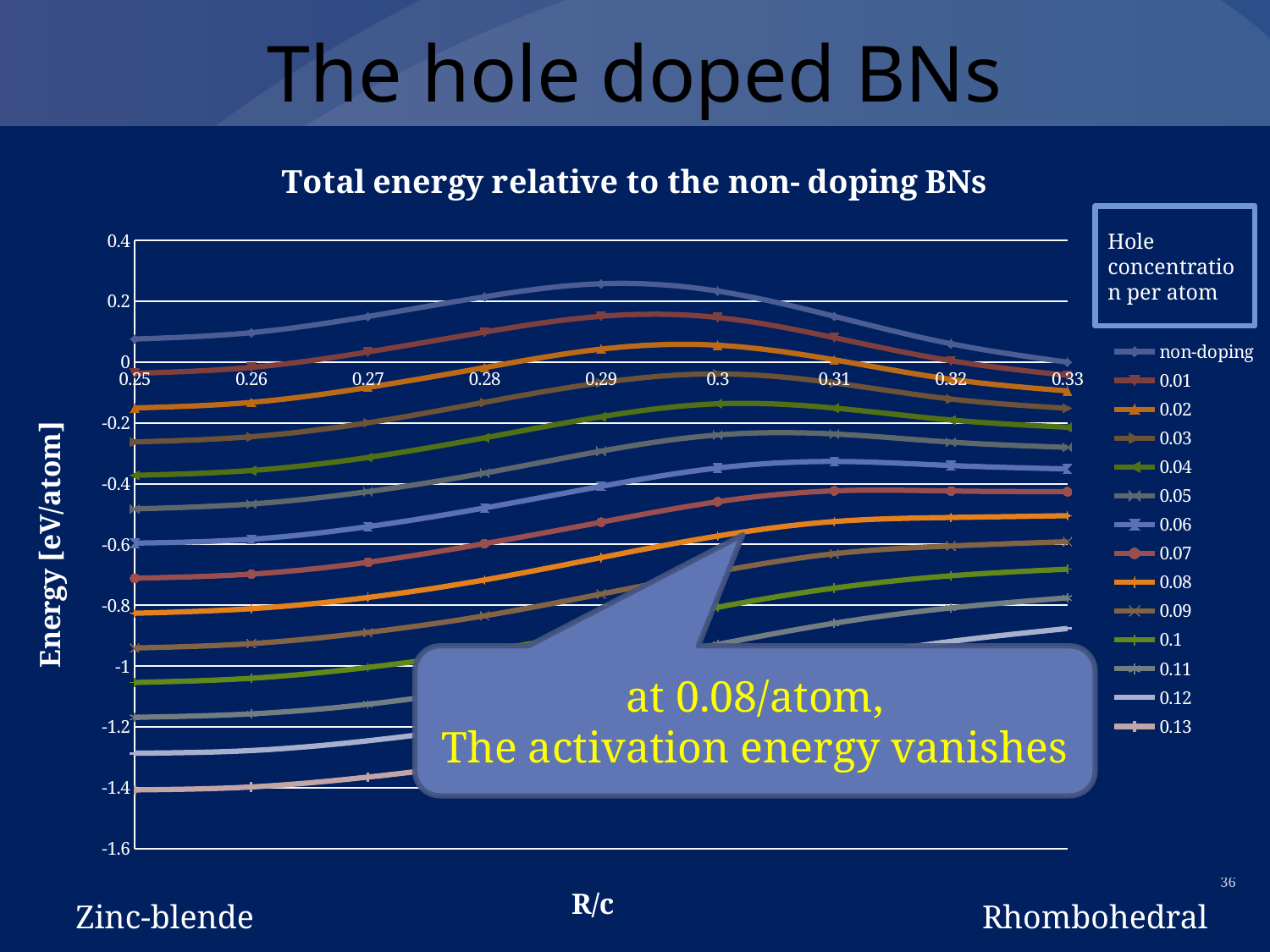
How many series does the chart legend list? 14 Which series has the lowest value at R/c = 0.25? 0.13 What is the title of the chart? Total energy relative to the non- doping BNs What is the label of the vertical axis? Energy [eV/atom] Which series has the highest value at R/c = 0.25? non-doping How many tick values are labelled along the R/c axis? 9 Is the value of the 0.13 series at R/c = 0.25 greater or less than -1.2? less Is the value of the non-doping series at R/c = 0.25 greater or less than 0? greater Is the value of the 0.01 series at R/c = 0.29 greater or less than 0? greater What kind of chart is shown on the slide? line chart Does the 0.08 series rise or fall as R/c increases from 0.25 to 0.33? rise At R/c = 0.25, which is larger: the value of the non-doping series or the value of the 0.13 series? non-doping